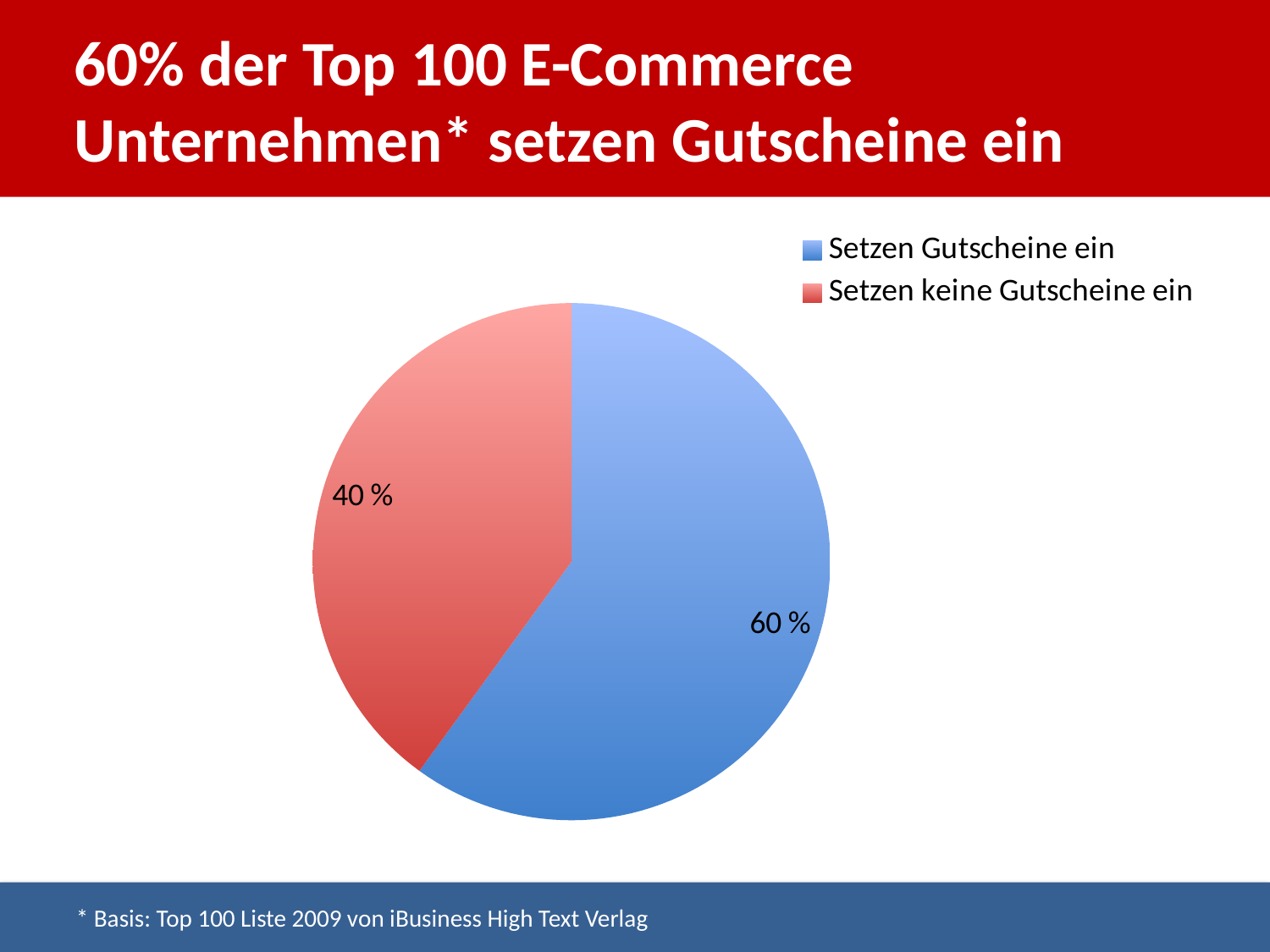
What colour is the "Setzen keine Gutscheine ein" slice? red What is the difference in percentage points between the "Setzen Gutscheine ein" slice and the "Setzen keine Gutscheine ein" slice? 20 percentage points Which slice of the pie is the largest? Setzen Gutscheine ein What share of the pie is labelled "Setzen Gutscheine ein"? 60 % What share of the pie is labelled "Setzen keine Gutscheine ein"? 40 % Which slice of the pie is the smallest? Setzen keine Gutscheine ein What colour is the "Setzen Gutscheine ein" slice? blue How many entries does the legend list? 2 How many slices does the pie chart have? 2 Which is larger: the "Setzen Gutscheine ein" slice or the "Setzen keine Gutscheine ein" slice? Setzen Gutscheine ein What kind of chart is shown on the slide? pie chart